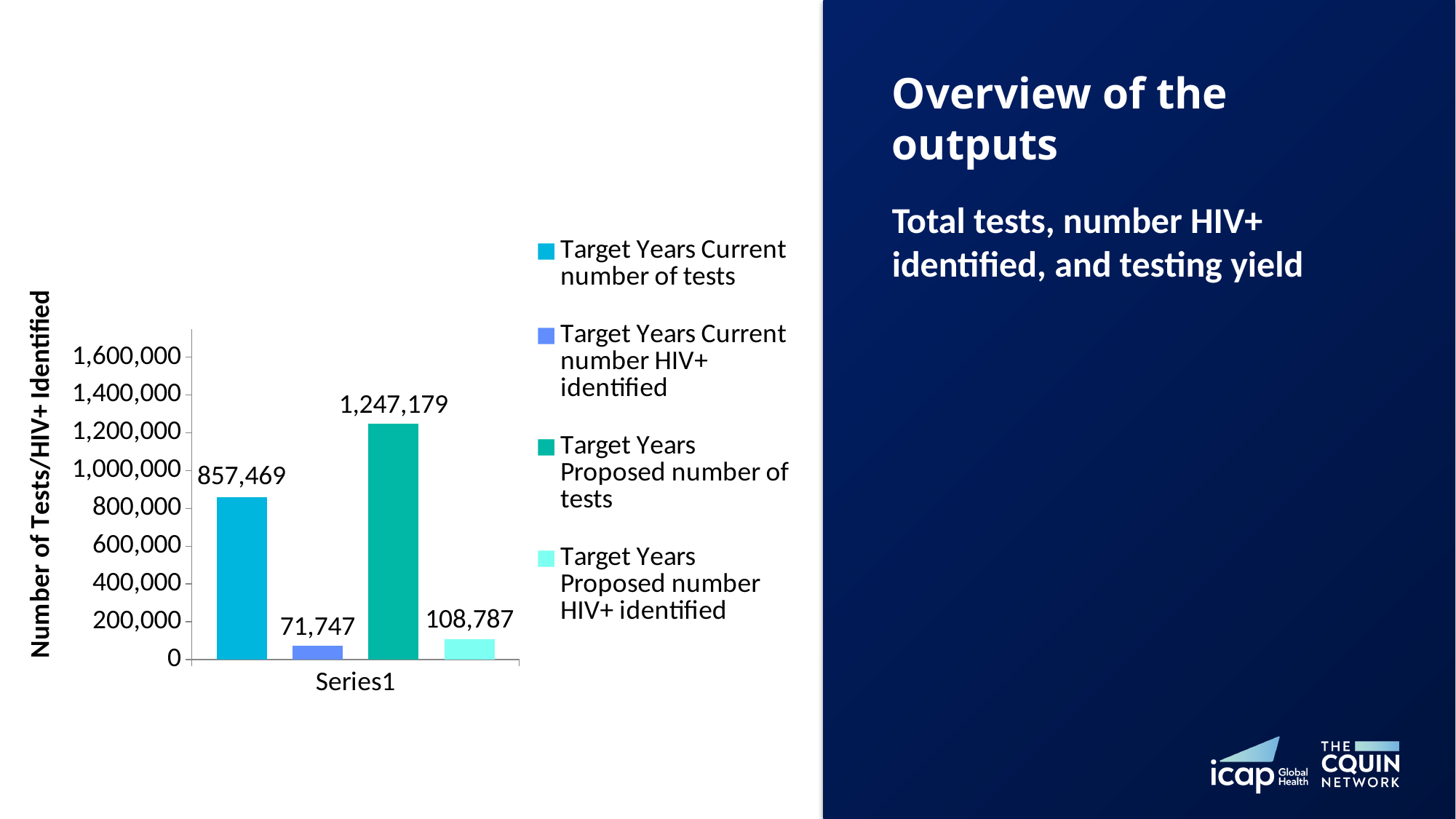
What is the label on the vertical axis of the chart? Number of Tests/HIV+ Identified What kind of chart is shown on the slide? Bar chart What is the value for Target Years Proposed number HIV+ identified? 108,787 What is the value for Target Years Current number HIV+ identified? 71,747 Which is larger, the Target Years Current number of tests or the Target Years Proposed number of tests? Target Years Proposed number of tests What is the difference between the Target Years Proposed number of tests and the Target Years Current number of tests? 389,710 What is the value for Target Years Current number of tests? 857,469 How many series does the legend list? 4 What is the value for Target Years Proposed number of tests? 1,247,179 Which series has the lowest value? Target Years Current number HIV+ identified What is the difference between the Target Years Proposed number HIV+ identified and the Target Years Current number HIV+ identified? 37,040 Which series has the highest value? Target Years Proposed number of tests